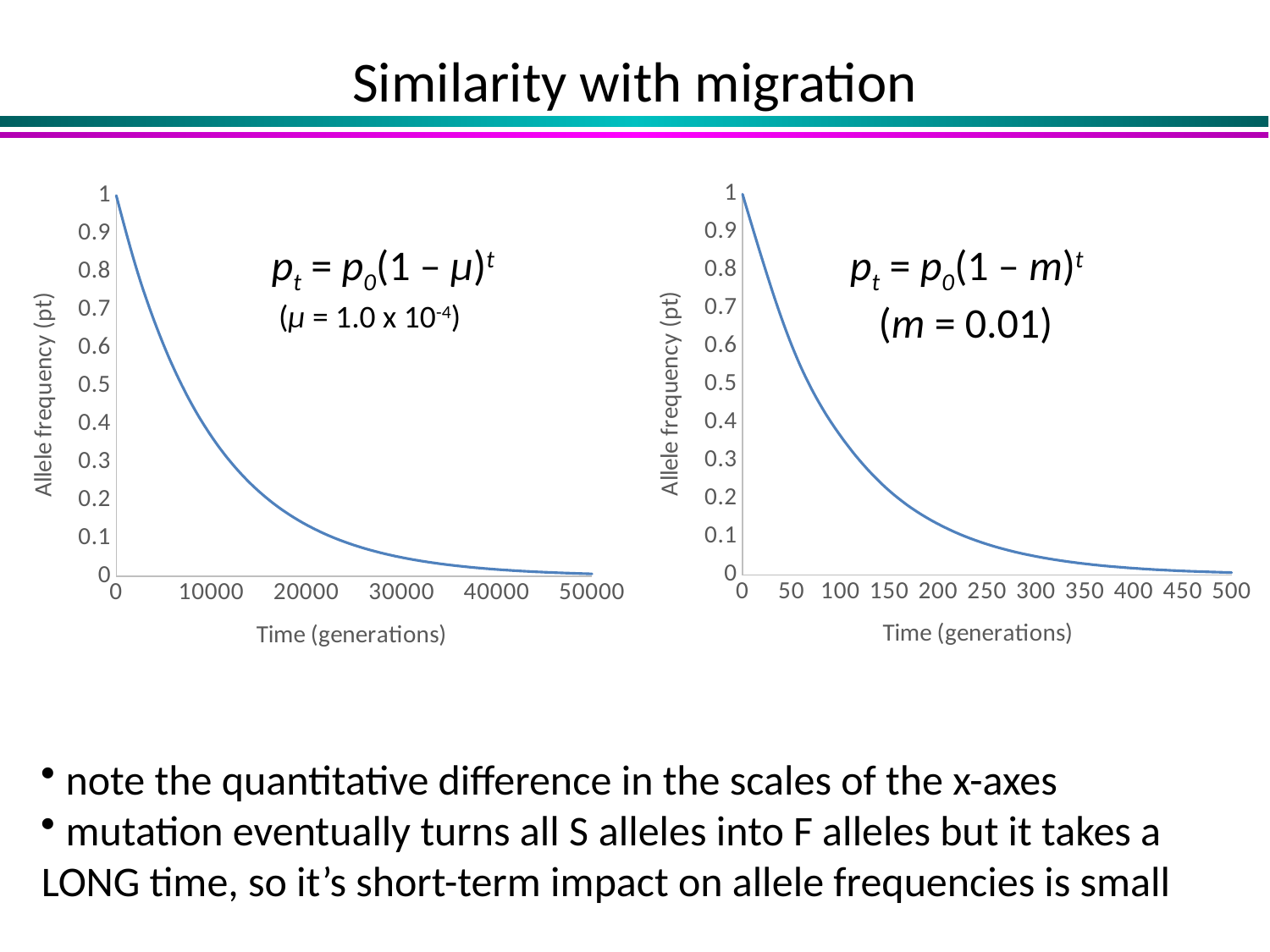
In the left chart (μ = 1.0 x 10⁻⁴), is the allele frequency at 10000 generations greater or less than 0.5? less What kind of chart is the left chart (μ = 1.0 x 10⁻⁴)? line chart In the right chart (m = 0.01), is the allele frequency at 200 generations greater or less than 0.2? less In the right chart (m = 0.01), what is the allele frequency at time 0? 1 In the left chart (μ = 1.0 x 10⁻⁴), is the allele frequency at 20000 generations greater or less than 0.2? less What is the largest value shown on the x axis of the left chart (μ = 1.0 x 10⁻⁴)? 50000 What kind of chart is the right chart (m = 0.01)? line chart In the left chart (μ = 1.0 x 10⁻⁴), does the allele frequency rise or fall as time increases? fall In the left chart (μ = 1.0 x 10⁻⁴), what is the allele frequency at time 0? 1 In the right chart (m = 0.01), does the allele frequency rise or fall as time increases? fall What is the y-axis title of the right chart (m = 0.01)? Allele frequency (pt)